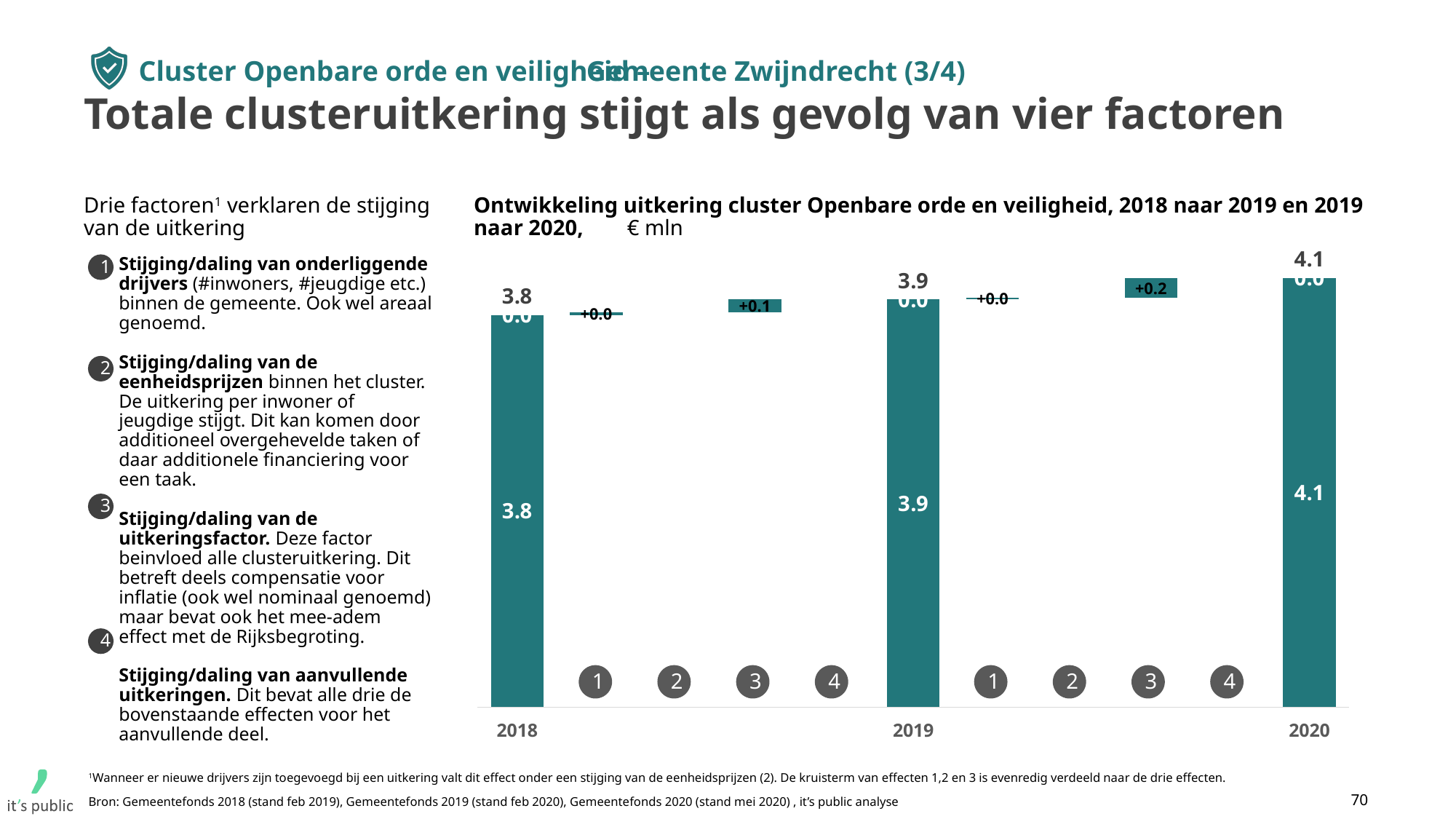
What is the total uitkering value shown for 2018? 3.8 Which is larger, the total for 2019 or the total for 2020? 2020 What is the total uitkering value shown for 2020? 4.1 What is the total uitkering value shown for 2019? 3.9 In what unit are the values in the chart expressed? € mln Do the total values rise or fall from 2018 to 2020? rise Which year has the highest total uitkering value? 2020 What is the difference between the 2020 and 2018 total values? 0.3 What is the difference between the 2019 and 2018 total values? 0.1 What is the value of the factor 3 effect between 2018 and 2019? +0.1 What is the value of the factor 3 effect between 2019 and 2020? +0.2 Which year has the lowest total uitkering value? 2018